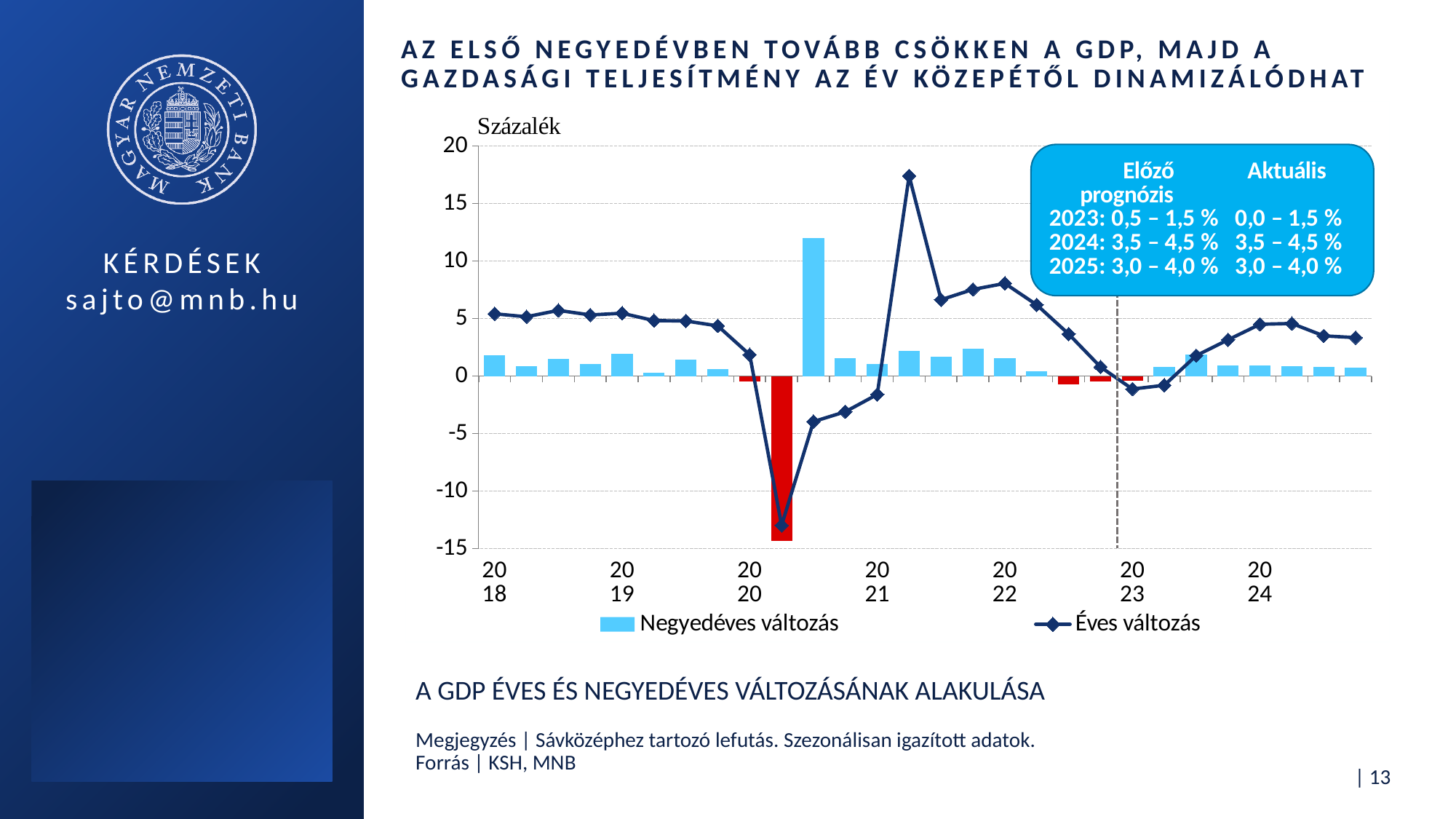
In which year does the Éves változás line reach its lowest point? 2020 In which year does the Éves változás line reach its highest point? 2021 How many series does the legend list? 2 How many year labels are shown on the horizontal axis? 7 What are the two series named in the legend? Negyedéves változás and Éves változás Is the lowest value of the Éves változás line greater or less than -10? less What kind of chart is shown on the slide? A combined bar and line chart What unit is shown at the top of the vertical axis? Százalék Is the red Negyedéves változás bar in 2020 greater or less than -10? less Does the Éves változás line rise or fall between its 2021 peak and the end of 2022? fall Is the tallest blue Negyedéves változás bar greater or less than 10? greater